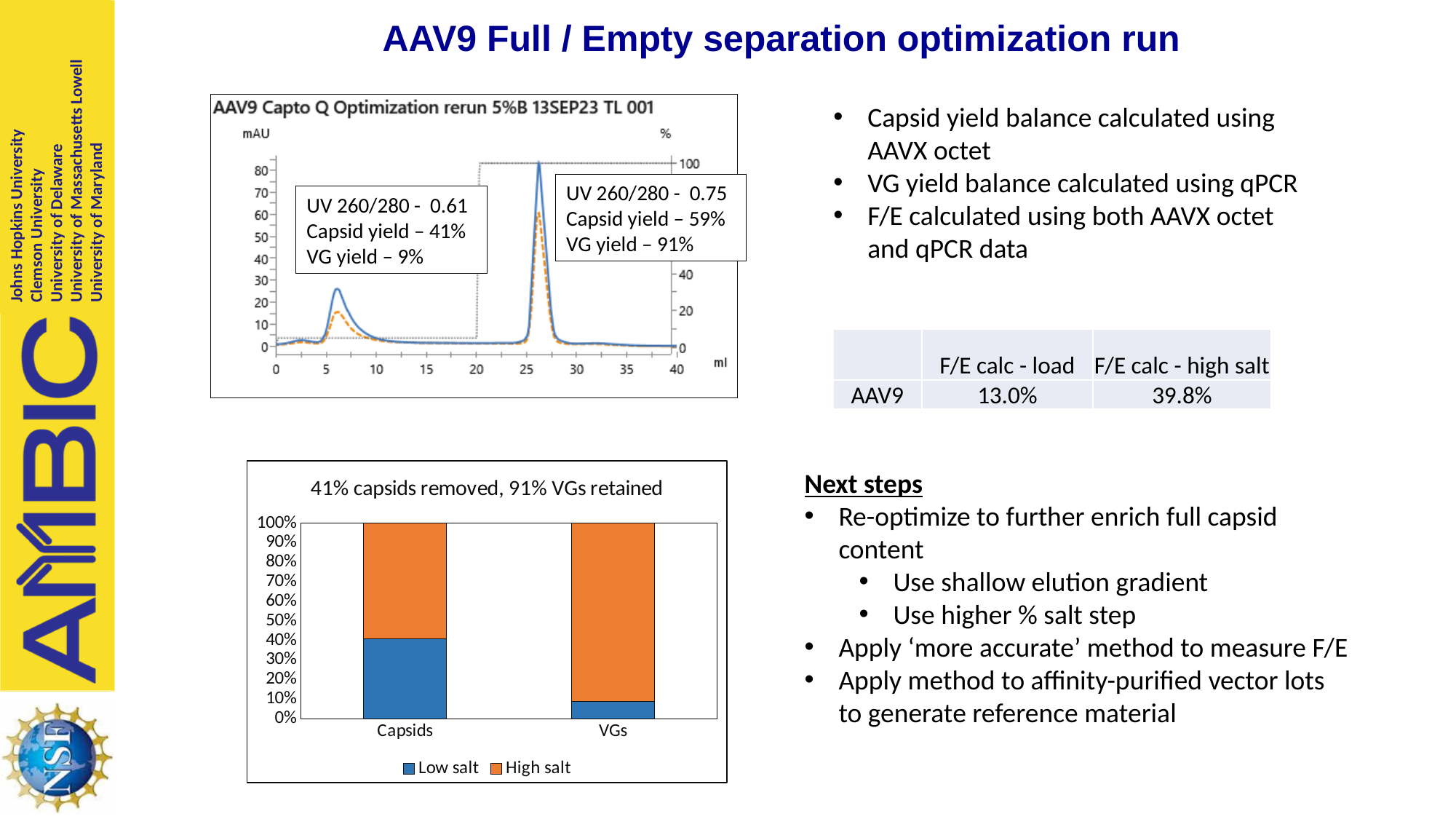
In the bar chart at the bottom left, which colour represents the High salt series? Orange In the chromatogram at the top left, is the peak near 26 ml greater or less than 60 mAU? greater In the bar chart at the bottom left, is the Low salt value for Capsids greater or less than 50%? less In the bar chart at the bottom left, which category has the larger Low salt portion, Capsids or VGs? Capsids In the bar chart at the bottom left, is the Low salt value for VGs greater or less than 20%? less How many series does the legend of the bar chart at the bottom left list? 2 What is the title of the bar chart at the bottom left of the slide? 41% capsids removed, 91% VGs retained What kind of chart is the chromatogram at the top left of the slide? Line chart How many categories are shown on the x axis of the bar chart at the bottom left? 2 In the bar chart at the bottom left, what is the total height of the stacked bar for VGs? 100% What kind of chart is the chart at the bottom left of the slide? Stacked bar chart